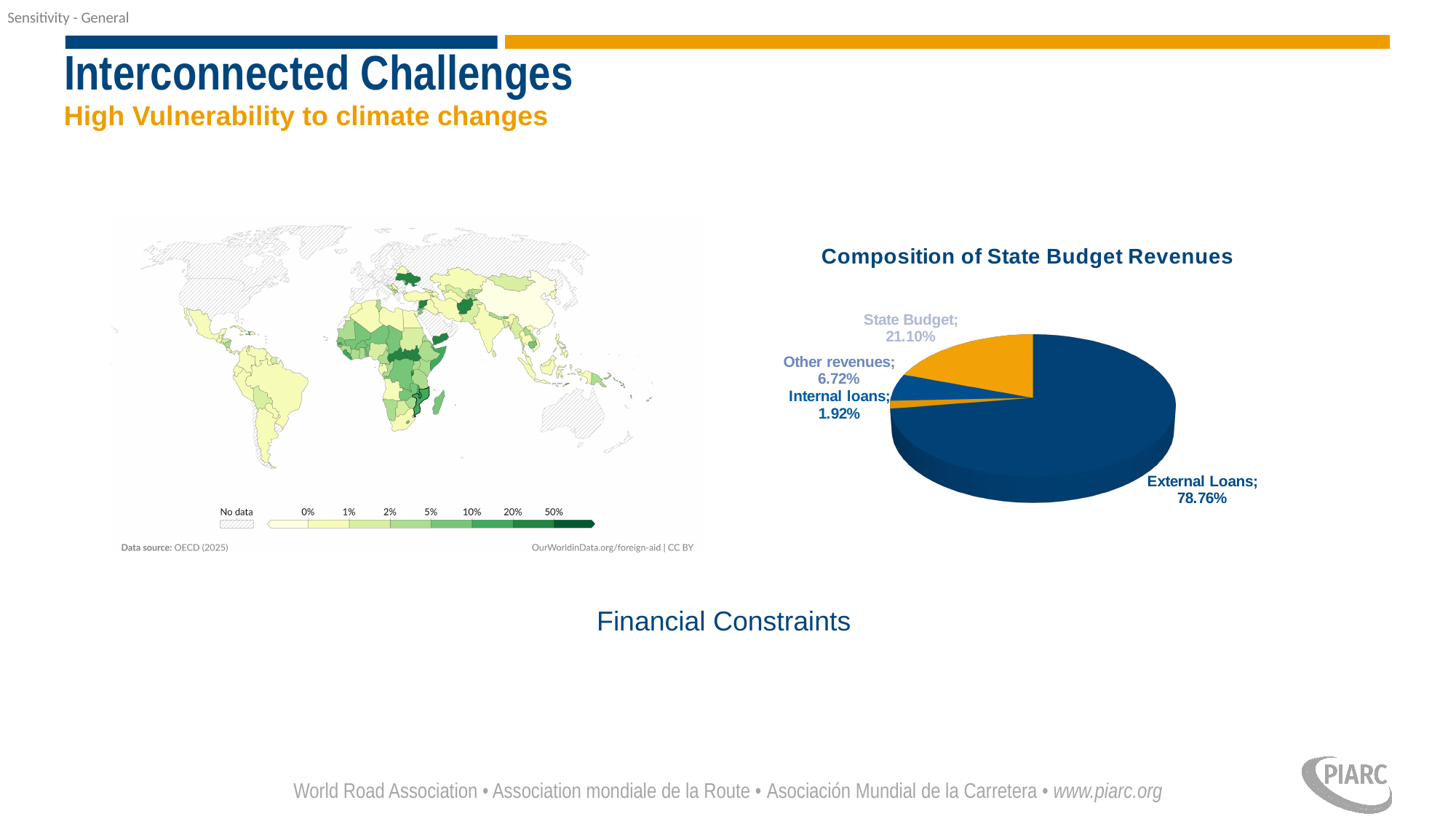
In the 'Composition of State Budget Revenues' chart, what is the value for Other revenues? 6.72% In the 'Composition of State Budget Revenues' chart, what colour is the State Budget slice? Orange In the 'Composition of State Budget Revenues' chart, what is the difference between the External Loans share and the State Budget share? 57.66% What kind of chart is the 'Composition of State Budget Revenues' chart? Pie chart In the 'Composition of State Budget Revenues' chart, which category has the smallest share? Internal loans In the 'Composition of State Budget Revenues' chart, what share do External Loans account for? 78.76% In the 'Composition of State Budget Revenues' chart, which category has the largest share? External Loans In the 'Composition of State Budget Revenues' chart, what is the difference between Other revenues and Internal loans? 4.80% How many slices does the 'Composition of State Budget Revenues' pie chart have? 4 In the 'Composition of State Budget Revenues' chart, what is the value for State Budget? 21.10% In the 'Composition of State Budget Revenues' chart, what is the value for Internal loans? 1.92% In the 'Composition of State Budget Revenues' chart, which is larger: State Budget or Other revenues? State Budget